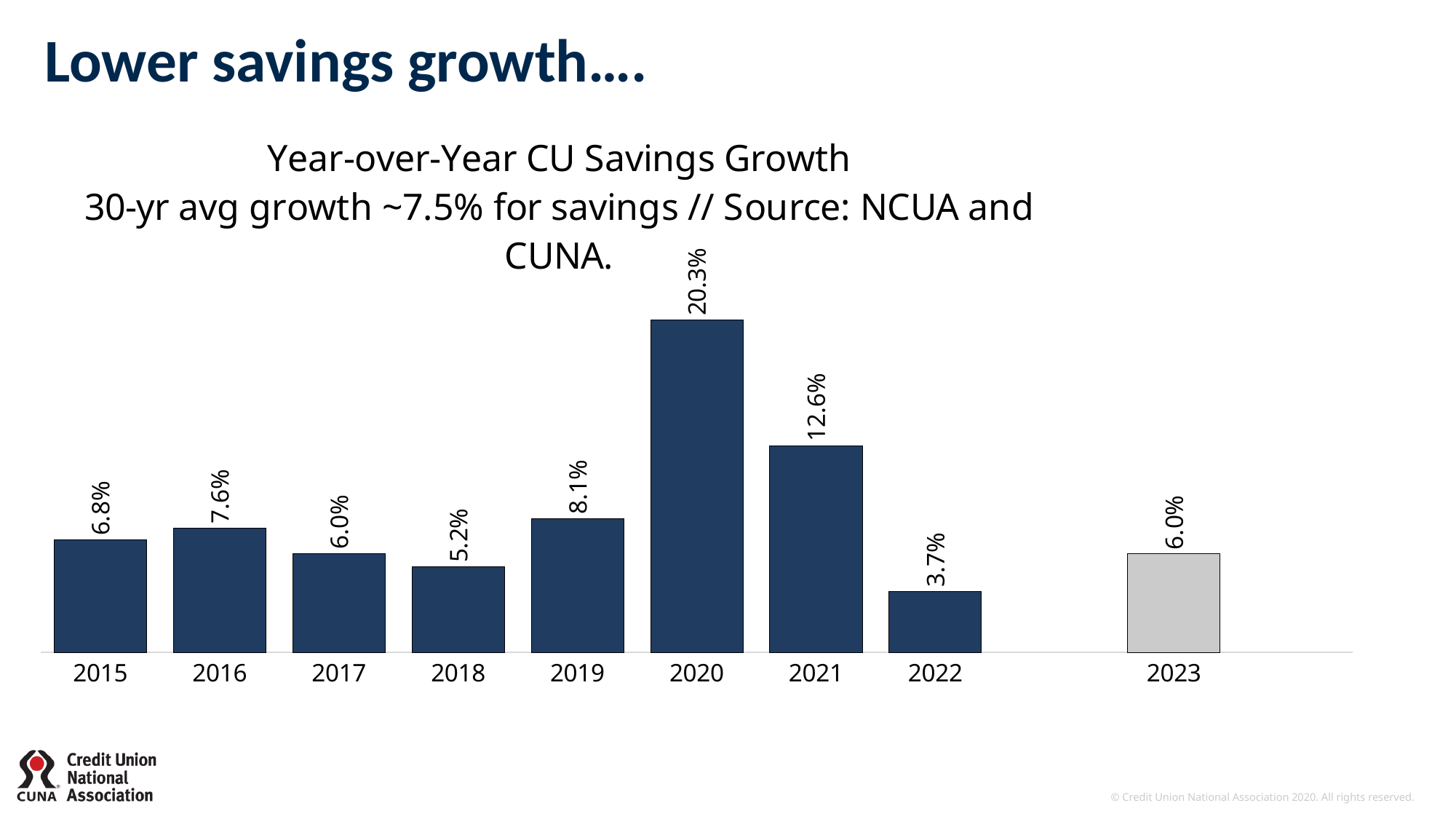
What is the difference between the savings growth in 2020 and 2021? 7.7% What is the difference between the savings growth in 2016 and 2015? 0.8% What kind of chart is shown on the slide? Bar chart Which year has the lowest savings growth? 2022 Which year's bar is shown in a different colour (grey) from the others? 2023 What is the year-over-year CU savings growth for 2020? 20.3% How many years are shown on the chart? 9 What is the savings growth value shown for 2018? 5.2% Which year has higher savings growth, 2019 or 2017? 2019 Which year has the highest savings growth? 2020 What is the savings growth value shown for 2023? 6.0% Do the values rise or fall from 2020 to 2022? Fall